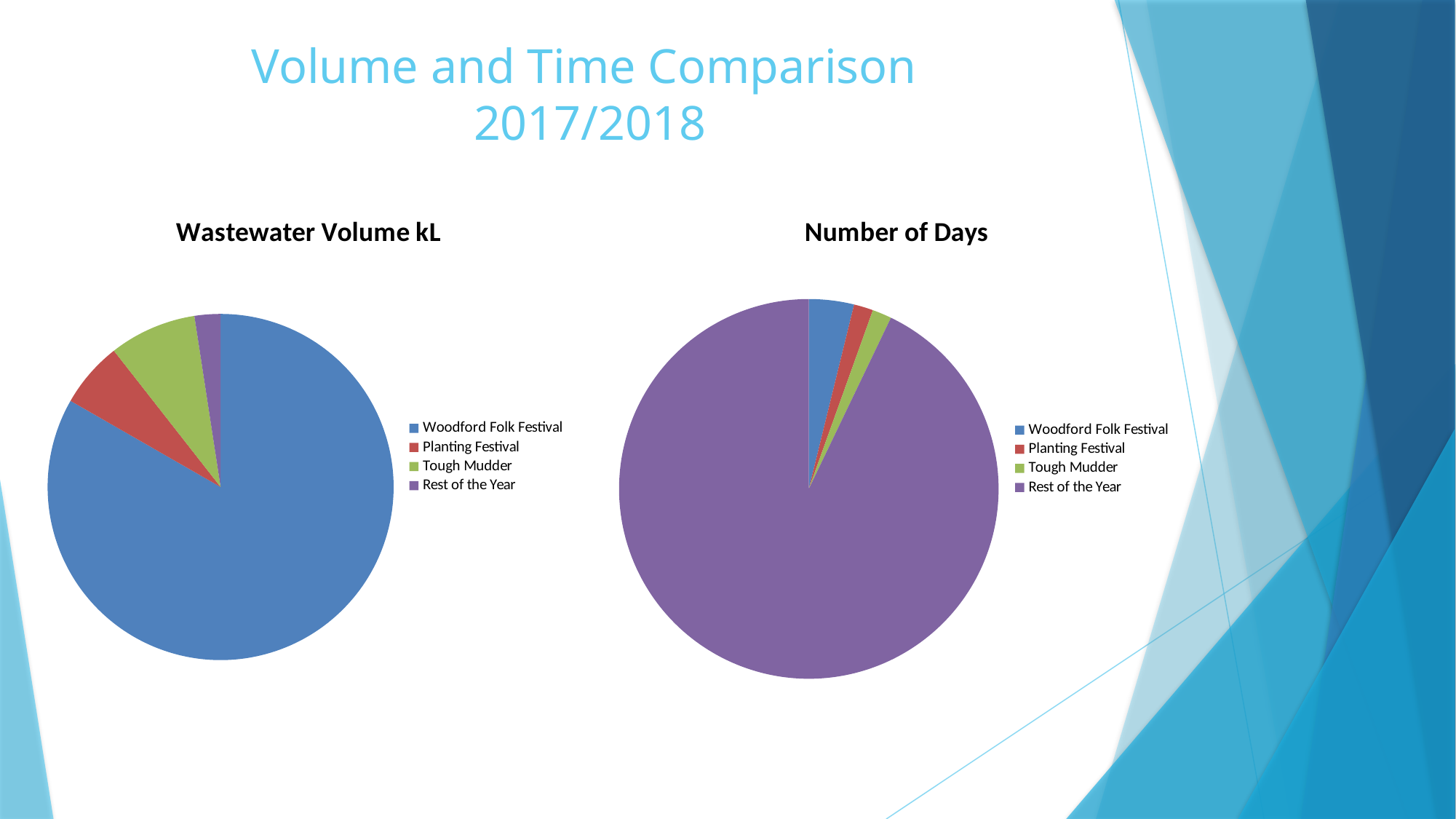
In the "Wastewater Volume kL" chart, which slice is larger: Tough Mudder or Planting Festival? Tough Mudder In the "Wastewater Volume kL" chart, which category has the largest slice? Woodford Folk Festival What kind of chart is the "Number of Days" chart? pie chart In the "Wastewater Volume kL" chart, which category has the smallest slice? Rest of the Year How many categories does the "Number of Days" pie chart have? 4 In the "Number of Days" chart, what colour is the Rest of the Year slice? purple In the "Number of Days" chart, which category has the largest slice? Rest of the Year In the "Number of Days" chart, which slice is larger: Woodford Folk Festival or Planting Festival? Woodford Folk Festival What is the title of the chart on the left of the slide? Wastewater Volume kL How many categories does the "Wastewater Volume kL" pie chart have? 4 What kind of chart is the "Wastewater Volume kL" chart? pie chart In the "Wastewater Volume kL" chart, which slice is larger: Planting Festival or Rest of the Year? Planting Festival